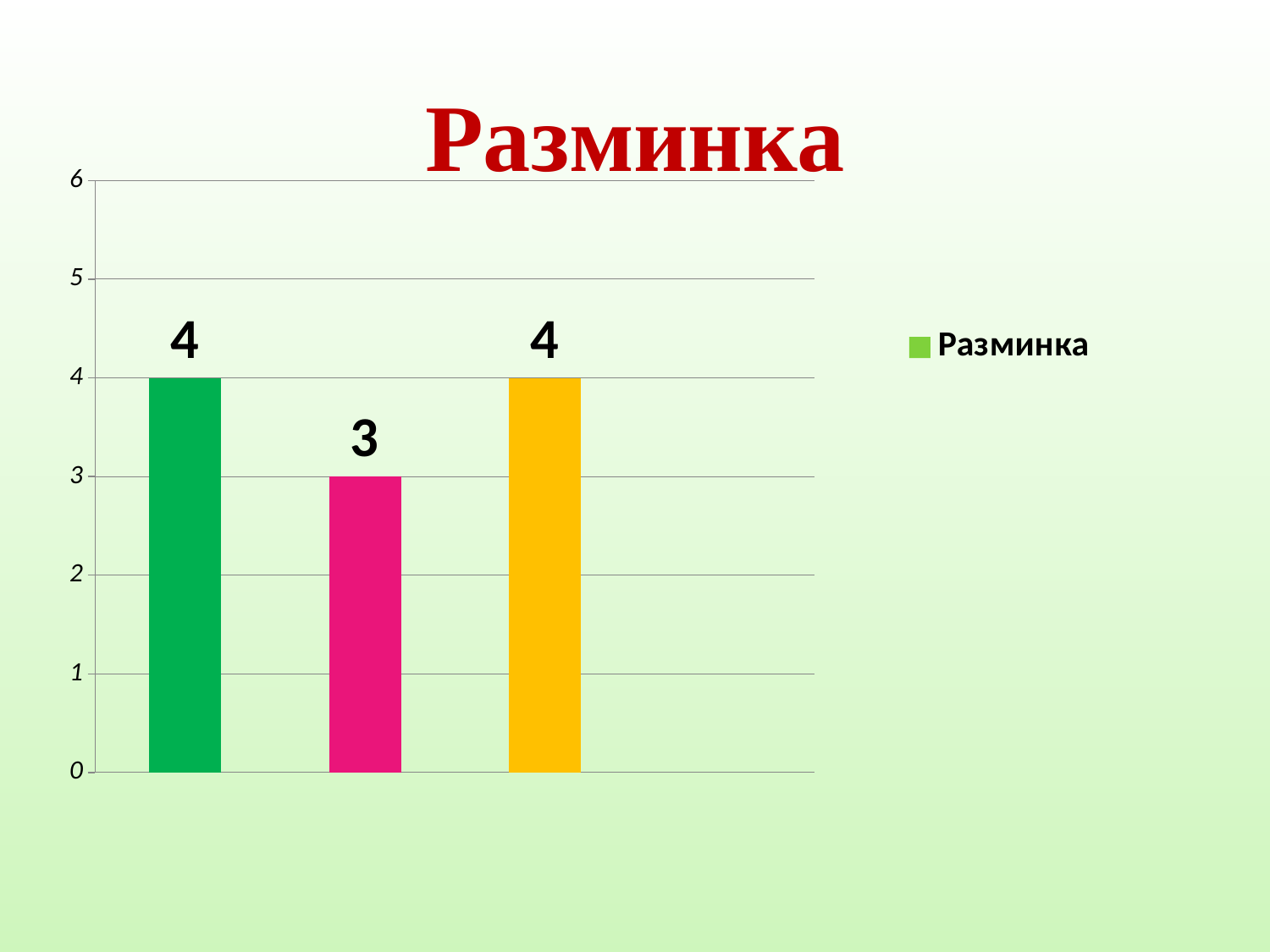
How many series does the legend list? 1 Which bar has the lowest value? the pink (middle) bar How many bars are plotted in the chart? 3 What is the value of the yellow (rightmost) bar? 4 Is the value of the pink bar greater or less than 4? less What is the title of the chart? Разминка What is the highest value shown on the vertical axis? 6 What kind of chart is shown on the slide? bar chart What is the difference between the green bar and the pink bar? 1 What is the value of the green bar? 4 What is the value of the pink (middle) bar? 3 Which is larger, the yellow bar or the pink bar? the yellow bar